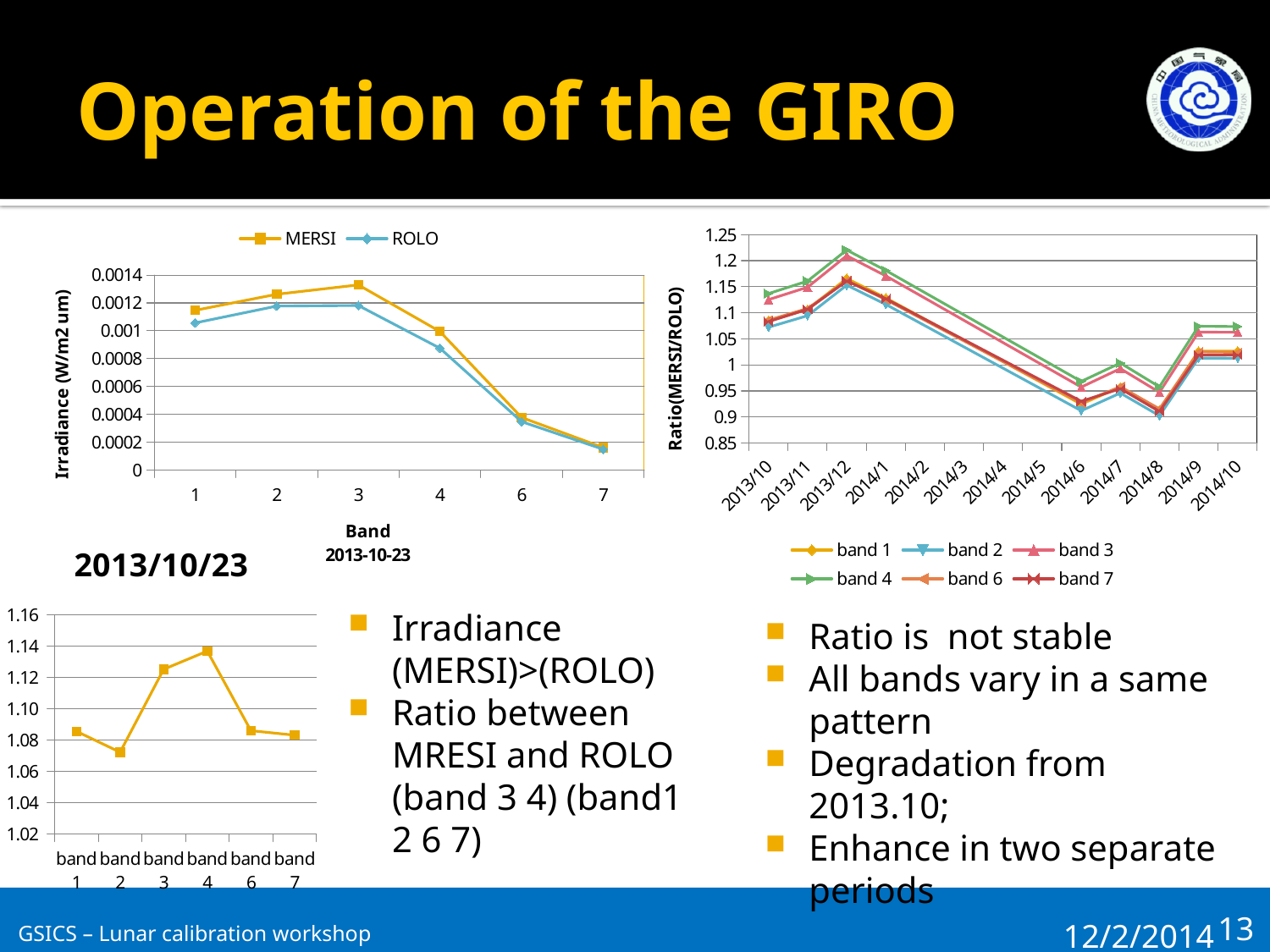
In the right-hand Ratio(MERSI/ROLO) chart, is the band 2 value at 2014/8 greater or less than 0.95? less In the top-left irradiance chart, is the MERSI value at band 1 greater or less than 0.001? greater In the bottom-left ratio chart, which band has the highest ratio? band 4 In the top-left irradiance chart, how many series does the legend list? 2 In the top-left irradiance chart, is the ROLO value at band 4 greater or less than 0.001? less In the top-left irradiance chart, what type of chart is shown? line chart In the right-hand Ratio(MERSI/ROLO) chart, how many series does the legend list? 6 In the top-left irradiance chart, at which band is the MERSI irradiance highest? 3 In the bottom-left ratio chart, which band has the lowest ratio? band 2 In the top-left irradiance chart, how many bands are plotted along the x axis? 6 In the top-left irradiance chart, do the MERSI values rise or fall from band 3 to band 7? fall In the top-left irradiance chart, at which band is the MERSI irradiance lowest? 7